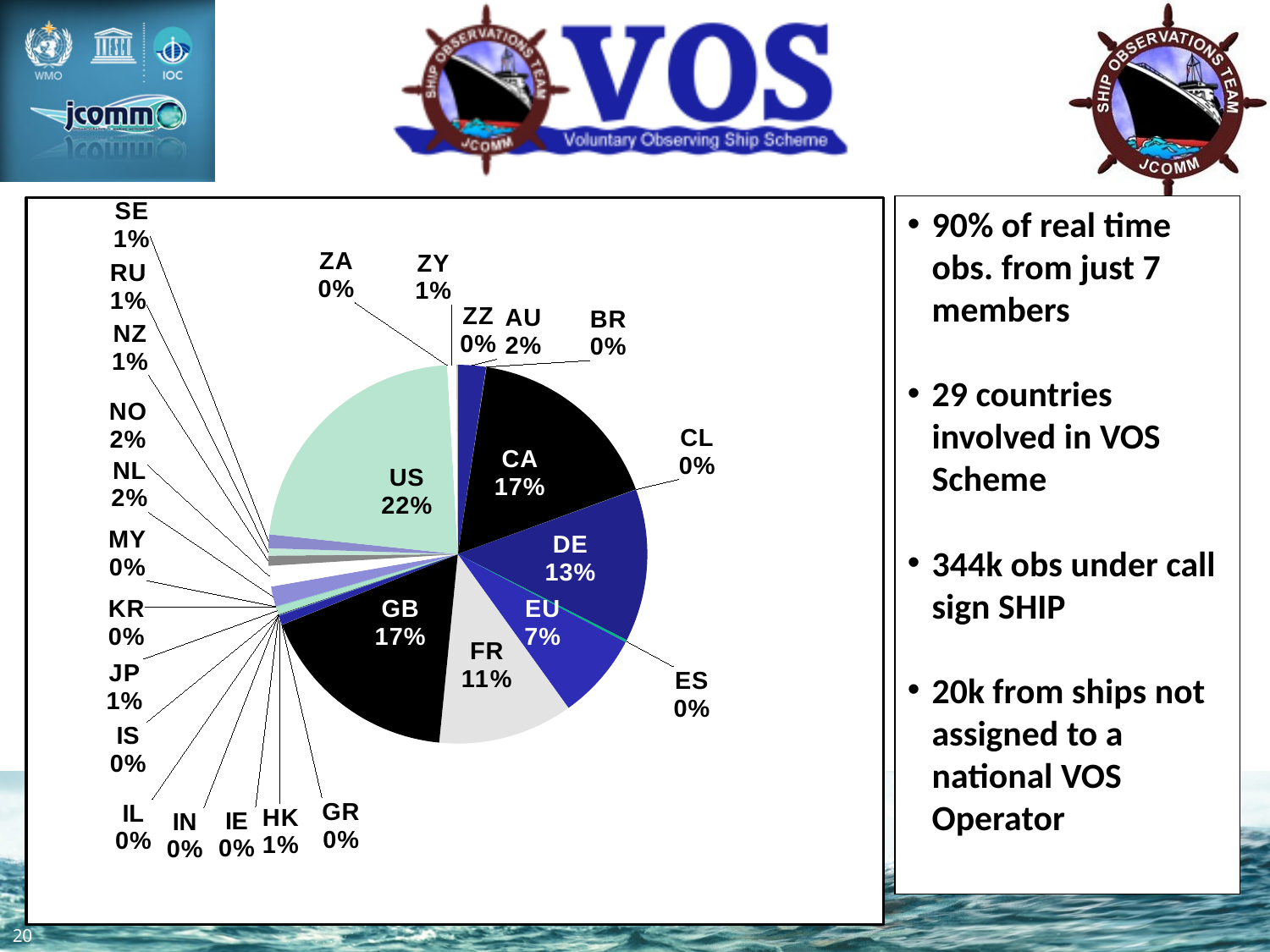
What is the value shown for EU? 7% What share of the pie does US account for? 22% What is the value shown for DE? 13% What is the difference between the US share and the CA share? 5% What type of chart is shown on the slide? pie chart What is the value shown for CA? 17% Which category has the largest slice of the pie? US What is the value shown for FR? 11% Which is larger, the slice for DE or the slice for EU? DE What is the value shown for AU? 2% What is the difference between the DE share and the EU share? 6% Which is larger, the slice for US or the slice for FR? US